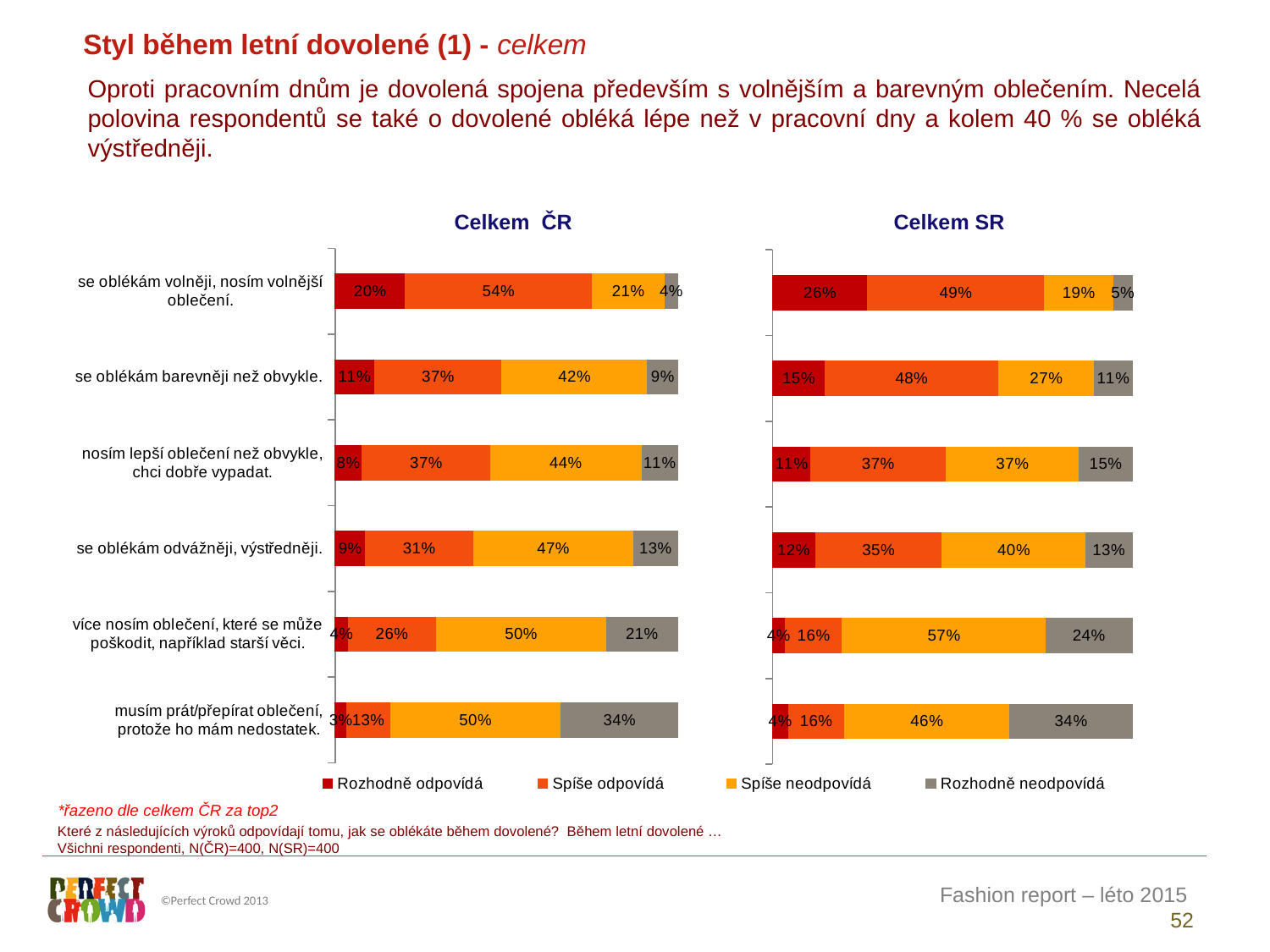
In the Celkem SR chart, what is the value of 'Rozhodně odpovídá' for 'se oblékám volněji, nosím volnější oblečení.'? 26% In the Celkem ČR chart, what is the value of 'Rozhodně neodpovídá' for 'musím prát/přepírat oblečení, protože ho mám nedostatek.'? 34% How many categories are shown in the Celkem ČR chart? 6 In the Celkem ČR chart, what is the value of 'Spíše odpovídá' for 'se oblékám volněji, nosím volnější oblečení.'? 54% In the Celkem ČR chart, which category has the highest 'Rozhodně odpovídá' value? se oblékám volněji, nosím volnější oblečení. In the Celkem SR chart, what is the combined total of 'Rozhodně odpovídá' and 'Spíše odpovídá' for 'nosím lepší oblečení než obvykle, chci dobře vypadat.'? 48% In the Celkem SR chart, which category has the lowest 'Spíše odpovídá' value? více nosím oblečení, které se může poškodit, například starší věci. and musím prát/přepírat oblečení, protože ho mám nedostatek. (both 16%) In the Celkem SR chart, what is the value of 'Spíše neodpovídá' for 'více nosím oblečení, které se může poškodit, například starší věci.'? 57% How many series does the legend list? 4 In the Celkem ČR chart, what is the difference between the 'Spíše neodpovídá' values for 'se oblékám odvážněji, výstředněji.' and 'se oblékám barevněji než obvykle.'? 5% What type of chart is the Celkem SR chart? Stacked bar chart Which is larger: the 'Spíše odpovídá' value for 'se oblékám barevněji než obvykle.' in the Celkem ČR chart or in the Celkem SR chart? Celkem SR